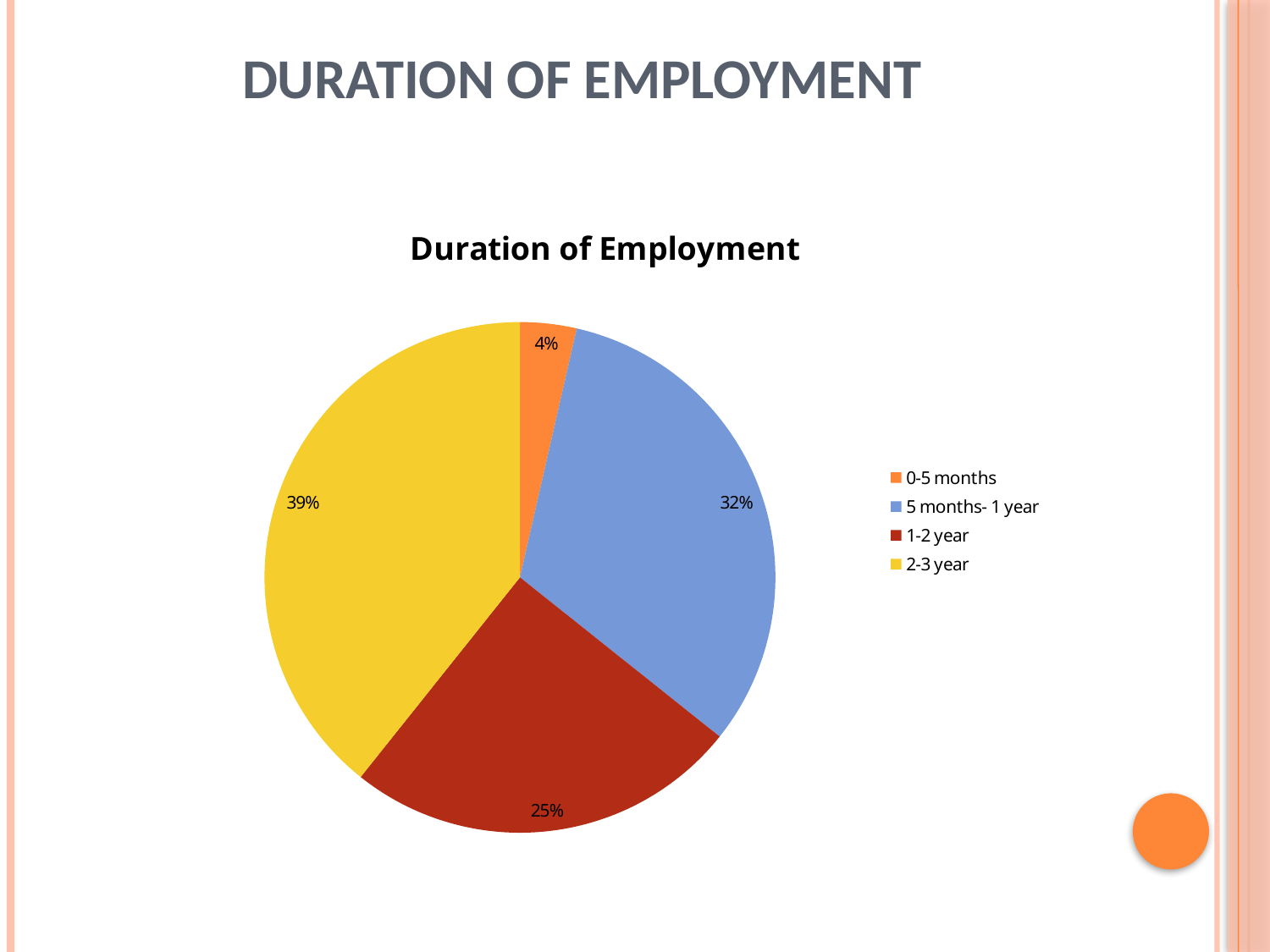
Which category has the largest slice of the pie? 2-3 year What share of the pie does the 5 months- 1 year category have? 32% Which category has the smallest slice of the pie? 0-5 months What is the title of the chart? Duration of Employment What share of the pie does the 1-2 year category have? 25% What kind of chart is shown on the slide? Pie chart How many categories does the pie chart show? 4 What is the difference in percentage points between the 2-3 year slice and the 1-2 year slice? 14 Which slice is larger: 5 months- 1 year or 1-2 year? 5 months- 1 year What colour is the slice for the 1-2 year category? Red What share of the pie does the 0-5 months category have? 4% What share of the pie does the 2-3 year category have? 39%